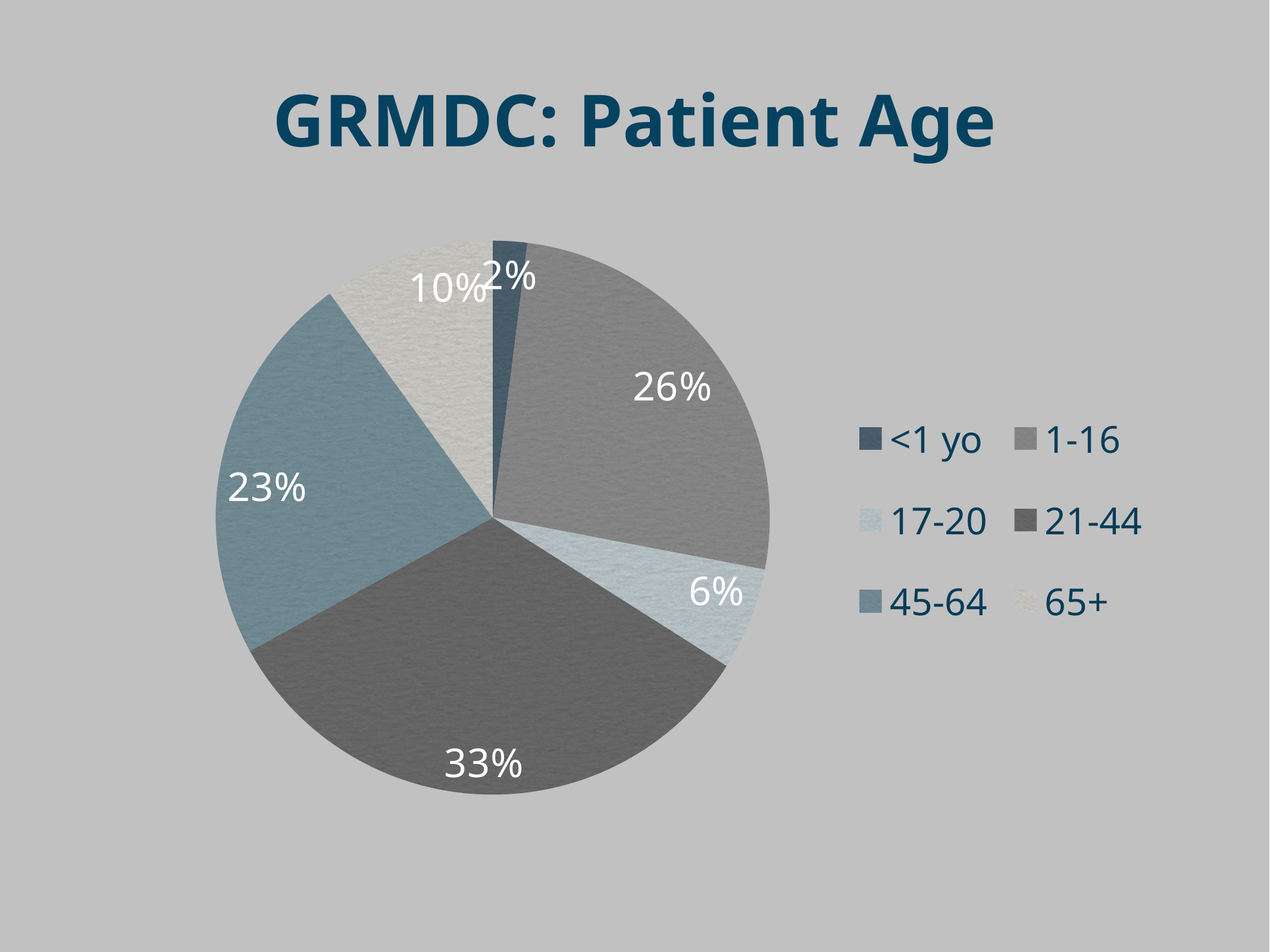
What is the title of the chart? GRMDC: Patient Age What kind of chart is shown on the slide? pie chart What share of patients are under 1 year old? 2% What share of patients are aged 17-20? 6% Which age group has the smallest share of patients? <1 yo What share of patients are aged 1-16? 26% How many percentage points larger is the 21-44 share than the 45-64 share? 10 What share of patients are aged 45-64? 23% What share of patients are aged 65+? 10% How many age groups does the legend list? 6 What share of patients are aged 21-44? 33% Which age group has the largest share of patients? 21-44